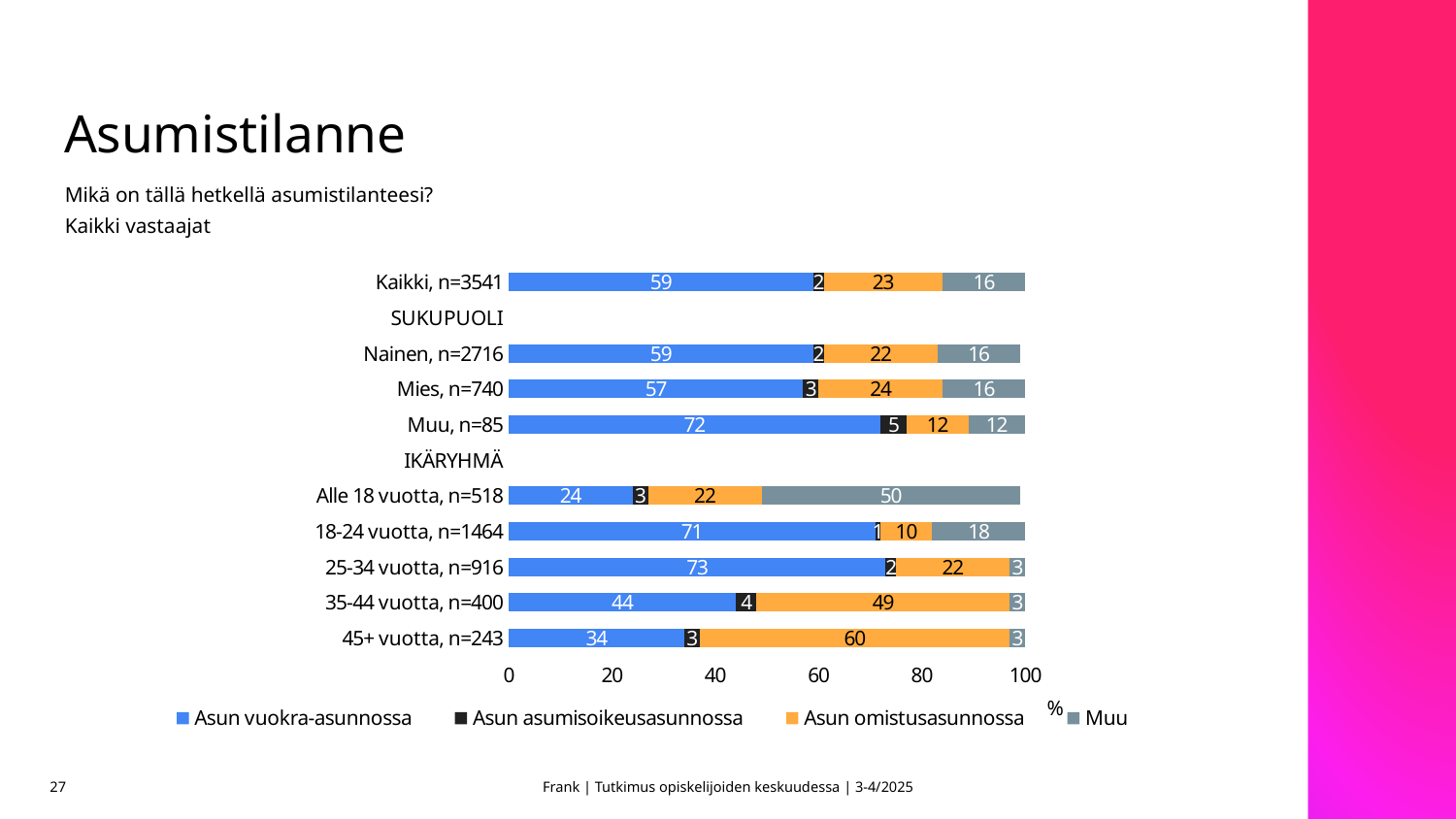
What percentage of all respondents (Kaikki, n=3541) live in a rental apartment (Asun vuokra-asunnossa)? 59 Which is larger: the Asun vuokra-asunnossa value for Nainen, n=2716 or for Mies, n=740? Nainen, n=2716 Which group has the lowest value for Asun vuokra-asunnossa? Alle 18 vuotta, n=518 Which group has the highest value for Asun vuokra-asunnossa? 25-34 vuotta, n=916 What is the total of the stacked bar for Muu, n=85? 101 What is the value for Asun omistusasunnossa in the 45+ vuotta, n=243 group? 60 How many series does the legend list? 4 What is the value for Asun asumisoikeusasunnossa in the 18-24 vuotta, n=1464 group? 1 What is the difference between the Asun omistusasunnossa values for 45+ vuotta, n=243 and 35-44 vuotta, n=400? 11 What kind of chart is shown on the slide? Stacked bar chart What is the value for Muu in the Alle 18 vuotta, n=518 group? 50 Which series is shown in orange in the legend? Asun omistusasunnossa